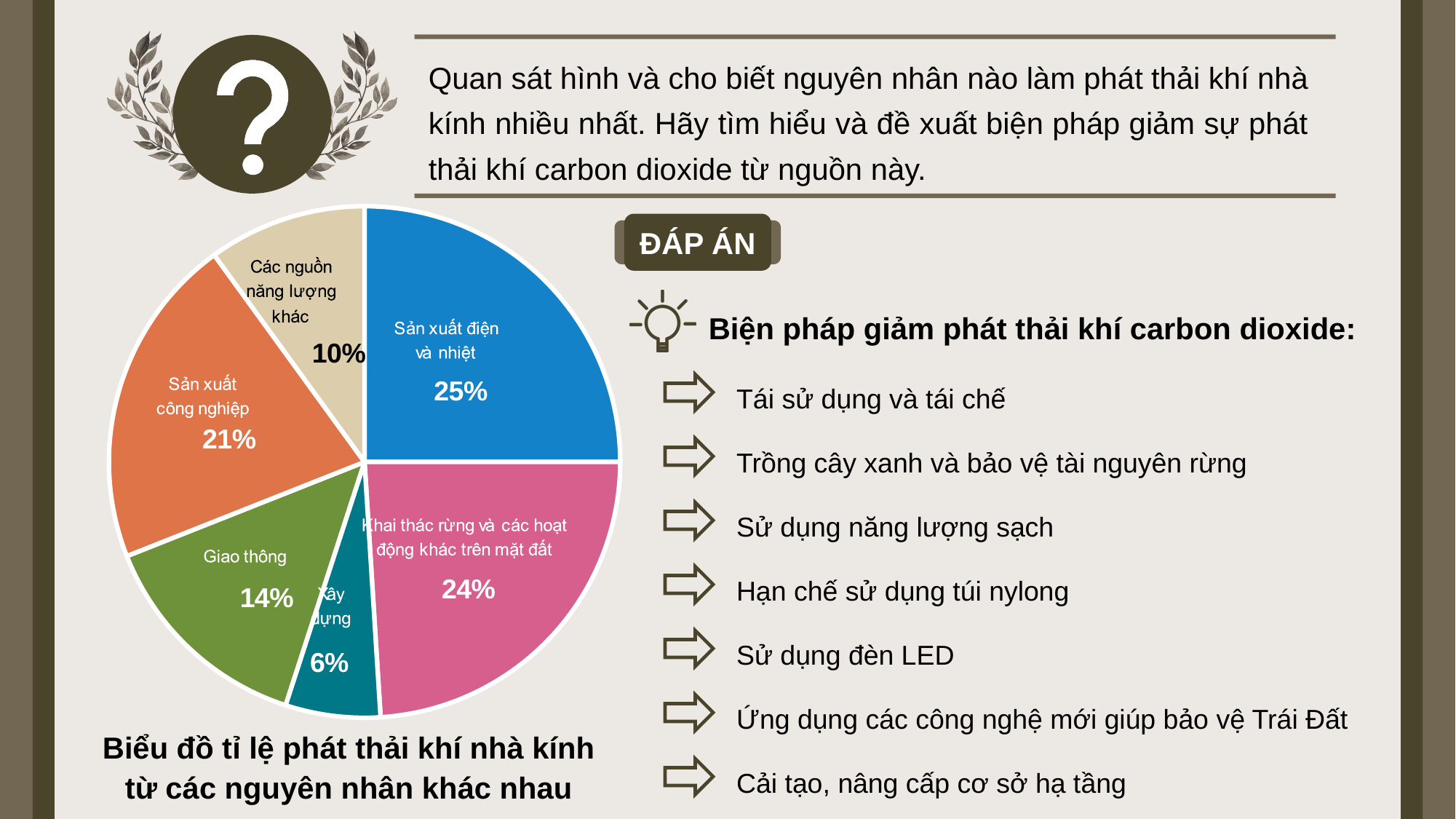
What is the value shown for 'Giao thông' in the pie chart? 14% What share does 'Xây dựng' have in the pie chart? 6% What is the title written below the pie chart? Biểu đồ tỉ lệ phát thải khí nhà kính từ các nguyên nhân khác nhau What kind of chart is shown on the slide? Pie chart What is the difference between the shares of 'Sản xuất công nghiệp' and 'Các nguồn năng lượng khác'? 11% How many slices does the pie chart have? 6 What is the combined share of 'Sản xuất điện và nhiệt' and 'Khai thác rừng và các hoạt động khác trên mặt đất'? 49% What percentage is labelled for 'Khai thác rừng và các hoạt động khác trên mặt đất'? 24% Which category has the largest share in the pie chart? Sản xuất điện và nhiệt Which category has the smallest share in the pie chart? Xây dựng What percentage of greenhouse gas emissions does the chart attribute to 'Sản xuất điện và nhiệt'? 25% Which is larger: the share for 'Giao thông' or the share for 'Sản xuất công nghiệp'? Sản xuất công nghiệp